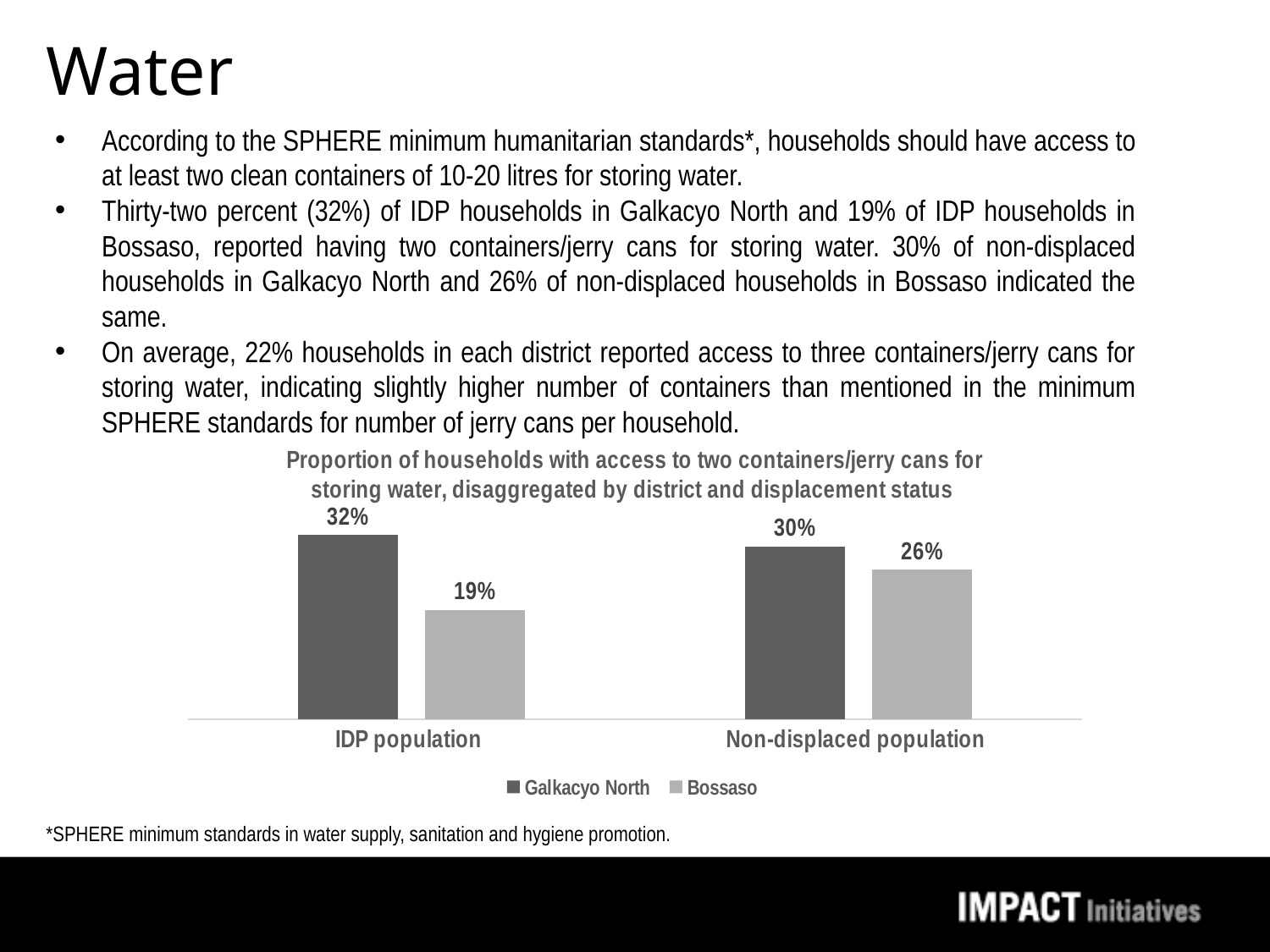
How many categories are shown on the x axis of the chart? 2 What is the value for Bossaso in the Non-displaced population category? 26% Which bar has the highest value in the chart? Galkacyo North, IDP population What kind of chart is shown on the slide? Bar chart What is the difference between Galkacyo North and Bossaso in the Non-displaced population category? 4% What is the value for Bossaso in the IDP population category? 19% What is the difference between Galkacyo North and Bossaso in the IDP population category? 13% Which bar has the lowest value in the chart? Bossaso, IDP population What is the value for Galkacyo North in the IDP population category? 32% Which is larger: Bossaso for the IDP population or Bossaso for the Non-displaced population? Bossaso for the Non-displaced population How many series does the legend list? 2 What is the value for Galkacyo North in the Non-displaced population category? 30%